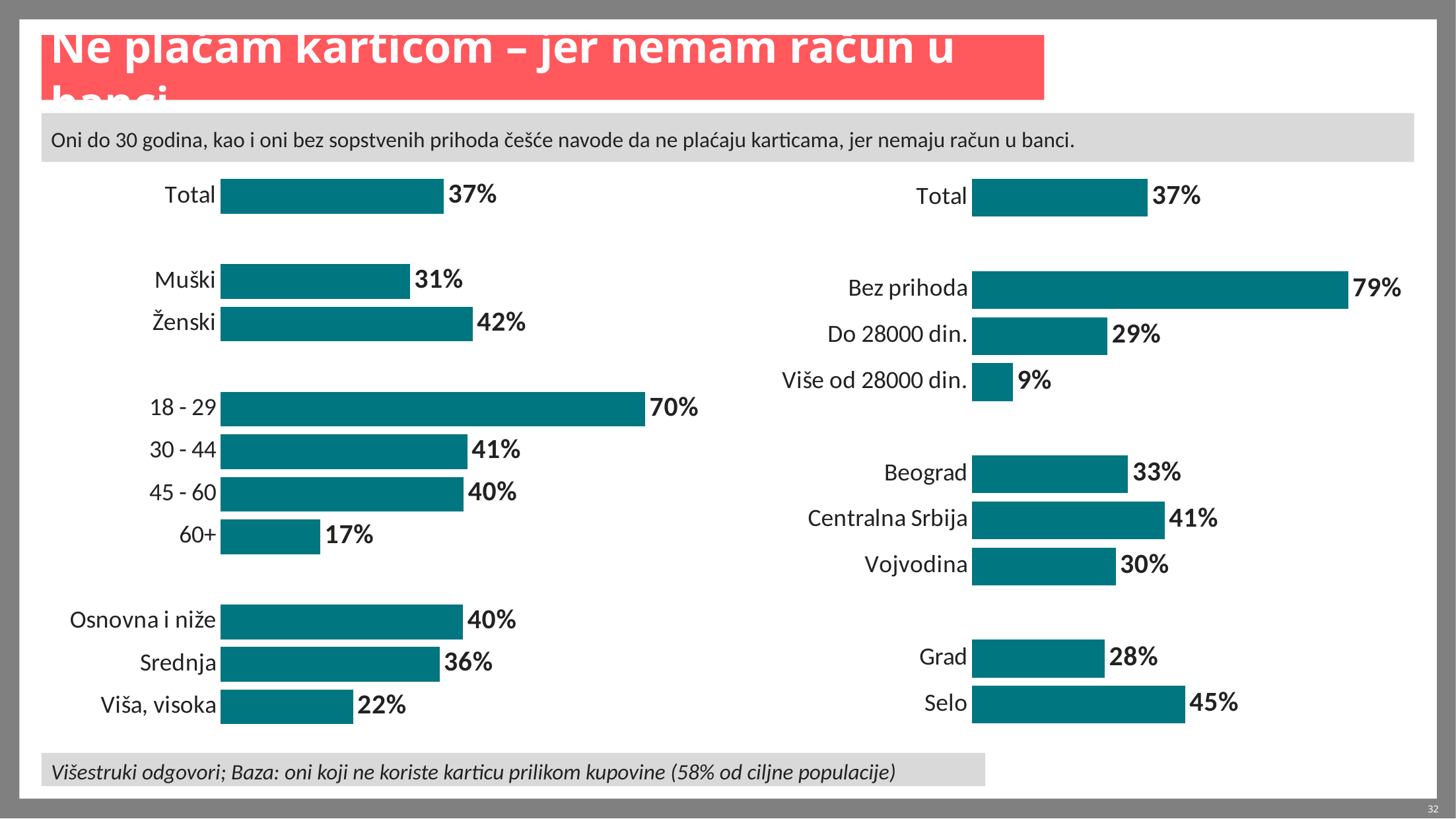
In the right chart, what is the value for Više od 28000 din.? 9% In the left chart, what is the value for Ženski? 42% In the right chart, which is larger, the value for Centralna Srbija or the value for Vojvodina? Centralna Srbija In the left chart, what is the value for the 18 - 29 age group? 70% What type of chart is the left chart? Bar chart How many categories are plotted in the left chart? 11 How many categories are plotted in the right chart? 9 In the right chart, which category has the highest value? Bez prihoda In the left chart, which category has the lowest value? 60+ In the left chart, what is the difference between the values for Ženski and Muški? 11% In the right chart, what is the difference between the values for Selo and Grad? 17% In the right chart, what is the value for Bez prihoda? 79%